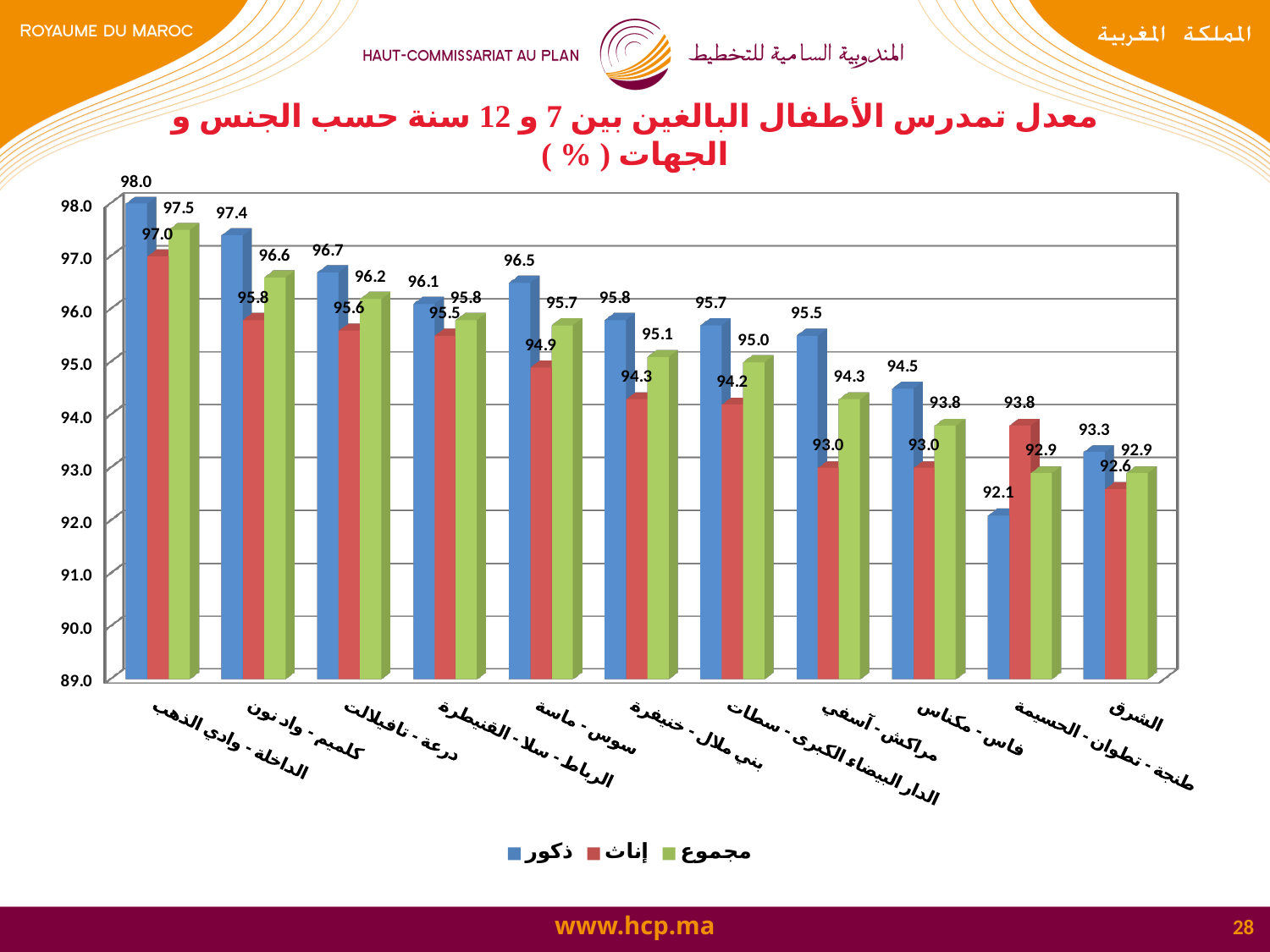
Which colour represents the مجموع series in the legend? green What is the value for إناث in سوس - ماسة? 94.9 What is the difference between the ذكور and إناث values in كلميم - واد نون? 1.6 Is the إناث value for الشرق greater or less than 93.0? less What is the value for مجموع in مراكش - آسفي? 94.3 In طنجة - تطوان - الحسيمة, which is larger, the ذكور value or the إناث value? إناث Which region has the highest مجموع value? الداخلة - وادي الذهب How many series does the legend list? 3 Which region has the lowest ذكور value? طنجة - تطوان - الحسيمة What type of chart is shown on the slide? bar chart How many regions (categories) are shown on the x axis? 11 What is the value for ذكور in الداخلة - وادي الذهب? 98.0